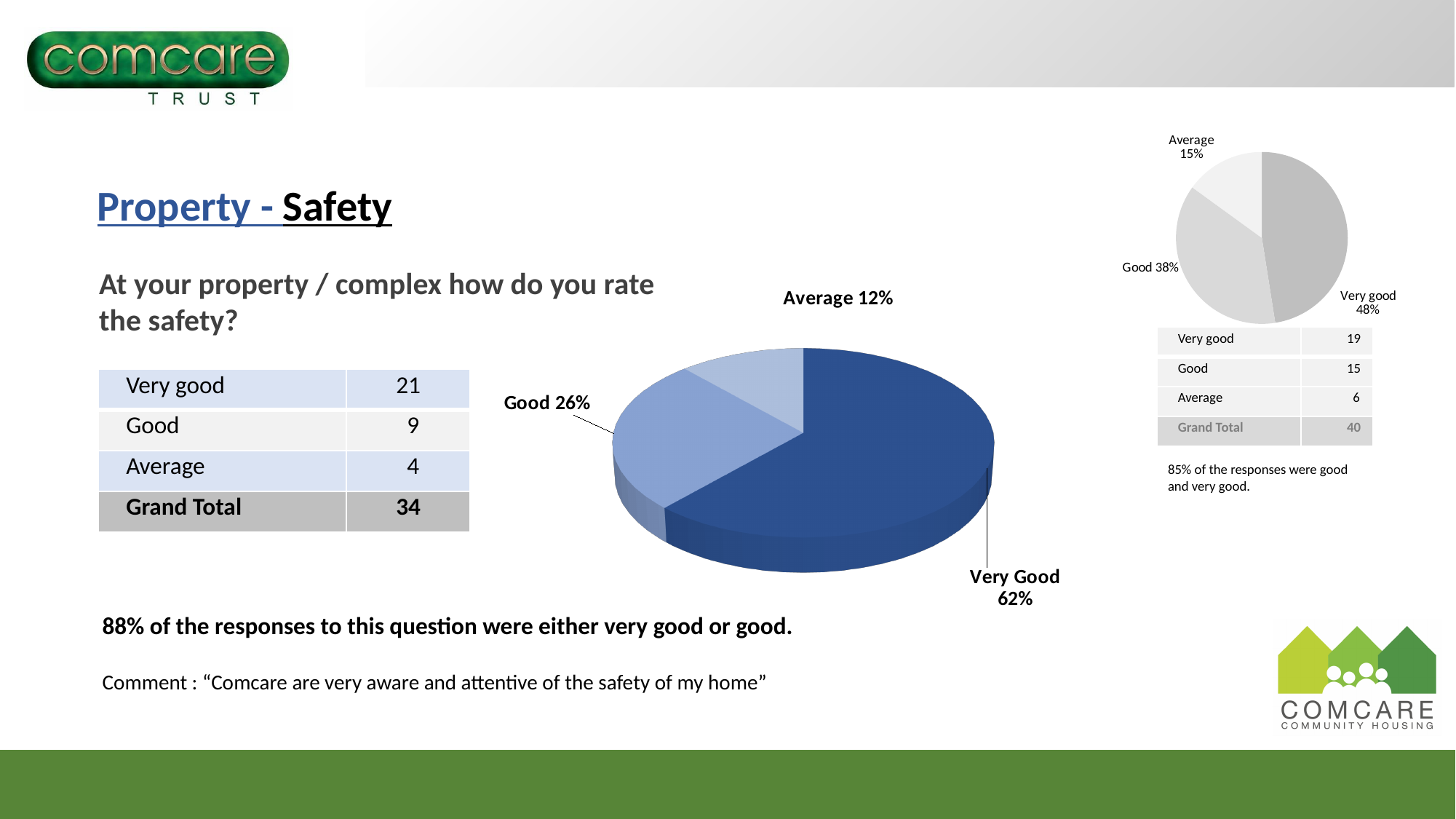
In the small grey pie chart at the top right of the slide, what share is labelled for Good? 38% In the large blue pie chart in the centre of the slide, what share is labelled for Average? 12% In the small grey pie chart at the top right of the slide, what share is labelled for Average? 15% In the large blue pie chart in the centre of the slide, which category has the largest slice? Very Good In the small grey pie chart at the top right of the slide, which category has the largest slice? Very good What type of chart is the large chart in the centre of the slide? Pie chart In the large blue pie chart in the centre of the slide, what is the difference in percentage points between the Very Good and Good slices? 36 In the large blue pie chart in the centre of the slide, which category has the smallest slice? Average How many slices does the large blue pie chart in the centre of the slide have? 3